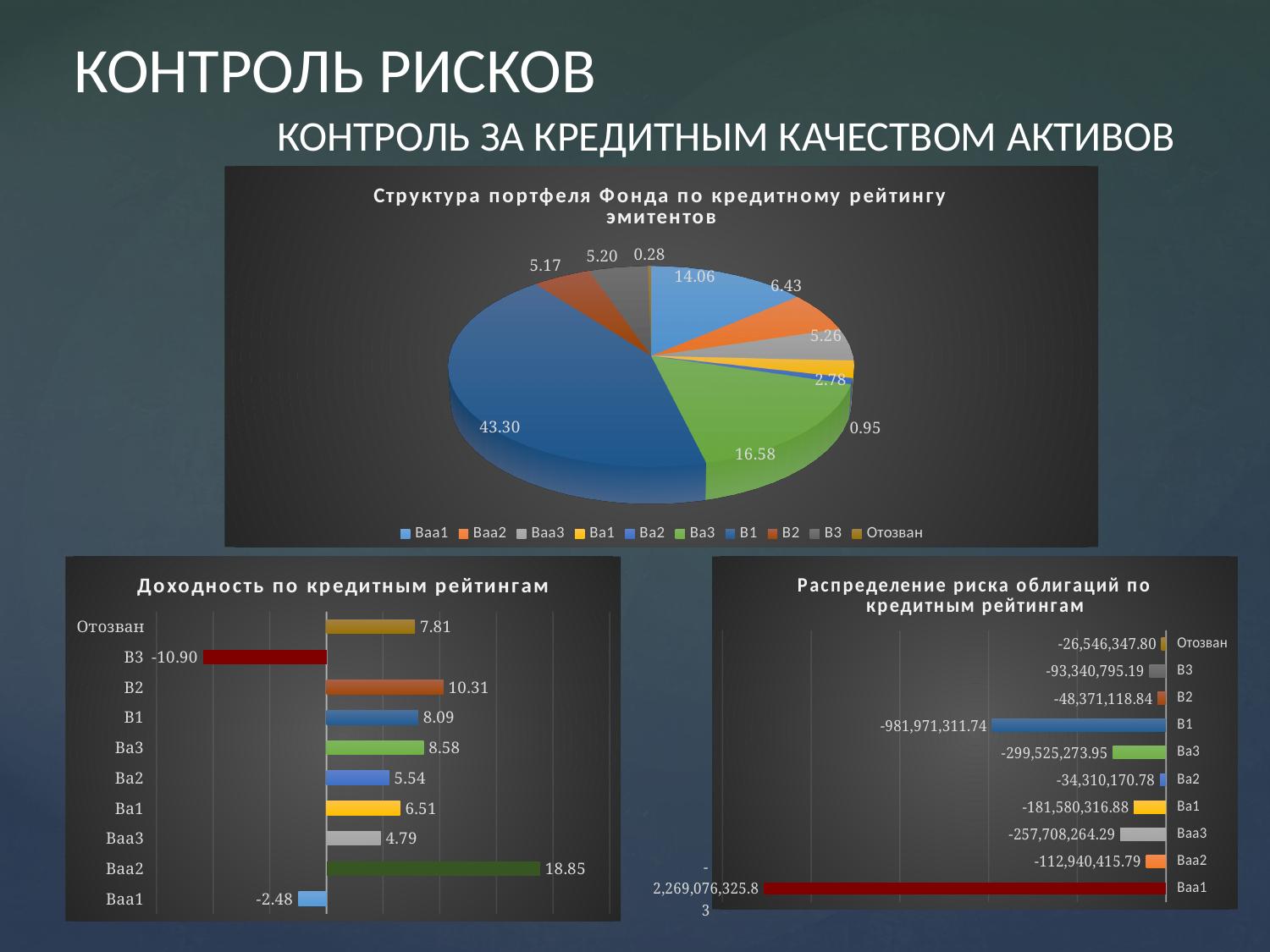
In the chart 'Доходность по кредитным рейтингам', which is larger, the value for B2 or the value for B1? B2 In the pie chart 'Структура портфеля Фонда по кредитному рейтингу эмитентов', which rating has the largest slice? B1 How many entries does the legend of the pie chart 'Структура портфеля Фонда по кредитному рейтингу эмитентов' list? 10 In the chart 'Доходность по кредитным рейтингам', what is the value for Baa2? 18.85 In the chart 'Доходность по кредитным рейтингам', what is the difference between the values for Baa2 and Baa3? 14.06 In the chart 'Распределение риска облигаций по кредитным рейтингам', which rating has the longest bar? Baa1 What kind of chart is 'Распределение риска облигаций по кредитным рейтингам'? bar chart In the pie chart 'Структура портфеля Фонда по кредитному рейтингу эмитентов', what is the value for Ba3? 16.58 In the chart 'Доходность по кредитным рейтингам', which rating has the lowest value? B3 In the chart 'Распределение риска облигаций по кредитным рейтингам', what is the value for B1? -981,971,311.74 In the chart 'Доходность по кредитным рейтингам', what is the value for B3? -10.90 In the pie chart 'Структура портфеля Фонда по кредитному рейтингу эмитентов', what is the value for B1? 43.30